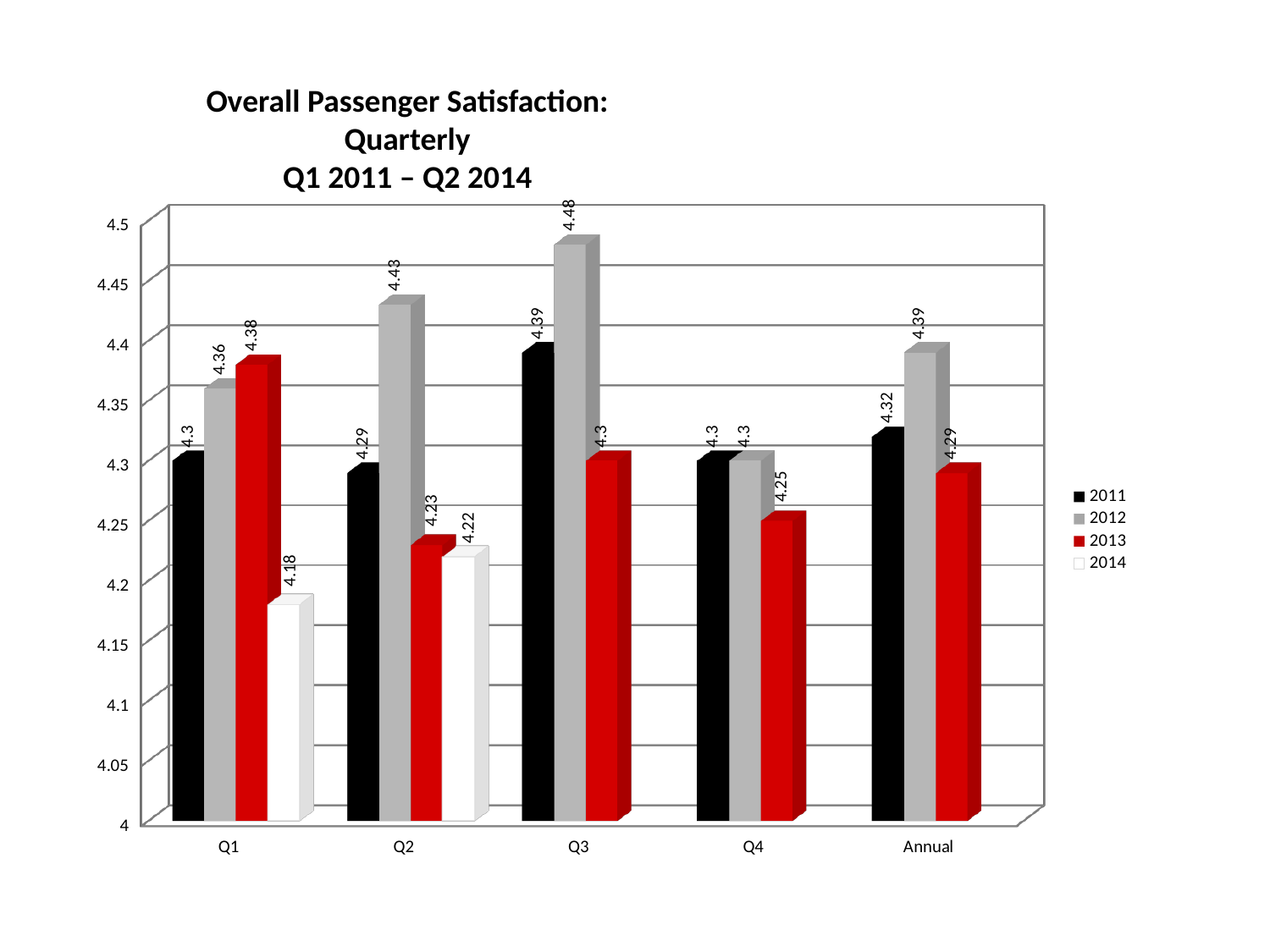
Which quarter has the highest 2012 value? Q3 What is the 2014 value for Q1? 4.18 Which category has the lowest 2013 value? Q2 Which is larger for Q1, the 2013 value or the 2014 value? 2013 What is the 2011 value for Q2? 4.29 What kind of chart is this? Bar chart Which series is shown in red? 2013 What is the 2012 value for Q3? 4.48 What is the difference between the 2012 and 2013 values for Q3? 0.18 What is the 2013 value for Annual? 4.29 How many series does the legend list? 4 How many categories are shown on the x axis? 5